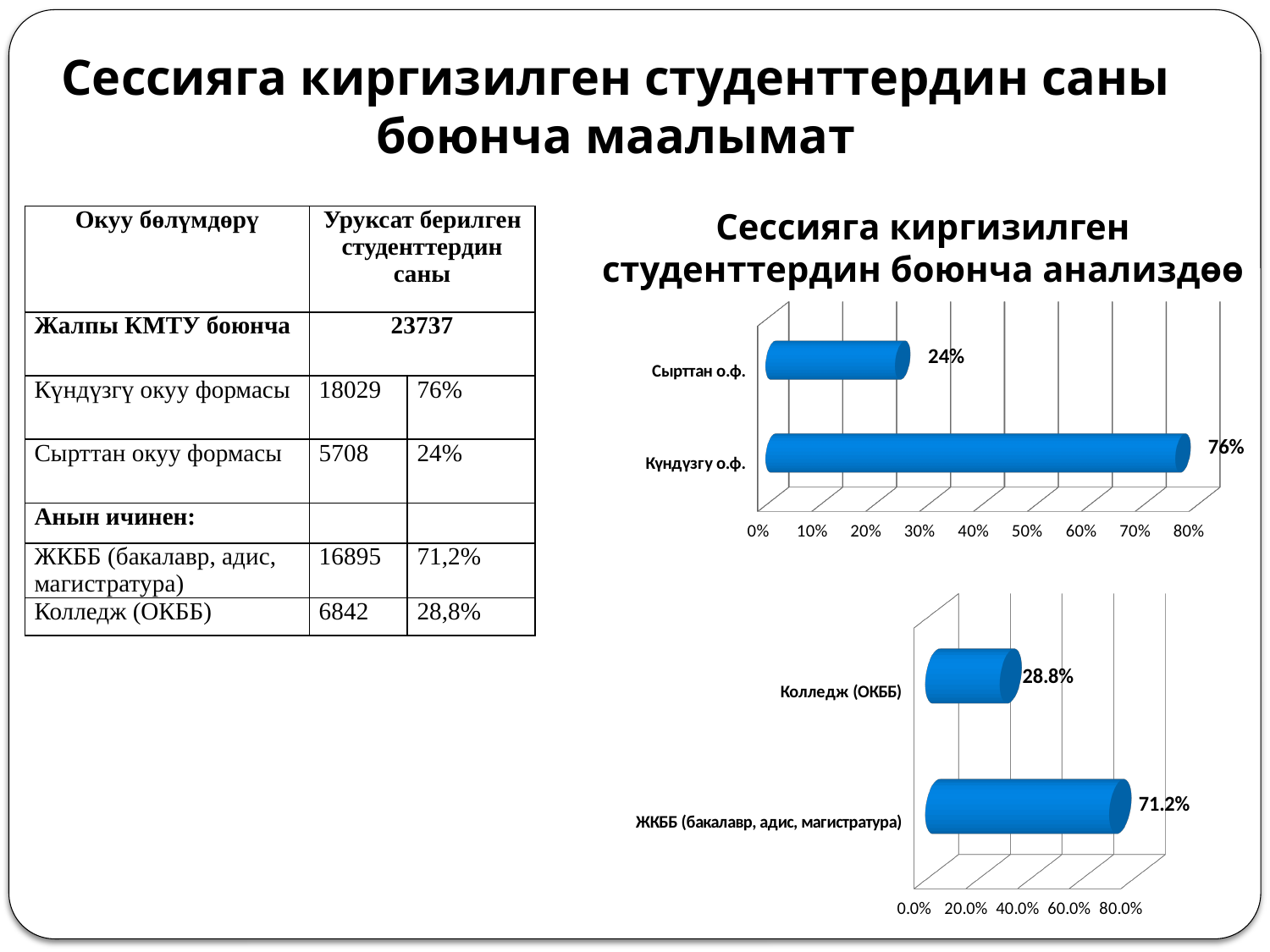
What kind of chart is the bottom chart on the slide? Bar chart In the top chart titled "Сессияга киргизилген студенттердин боюнча анализдөө", what is the value for Күндүзгү о.ф.? 76% In the bottom chart on the slide, what is the value for ЖКББ (бакалавр, адис, магистратура)? 71.2% In the bottom chart on the slide, what is the value for Колледж (ОКББ)? 28.8% In the top chart, which category has the highest value? Күндүзгү о.ф. In the top chart titled "Сессияга киргизилген студенттердин боюнча анализдөө", what is the value for Сырттан о.ф.? 24% In the bottom chart, which is larger: the value for Колледж (ОКББ) or the value for ЖКББ (бакалавр, адис, магистратура)? ЖКББ (бакалавр, адис, магистратура) What is the title of the top chart on the slide? Сессияга киргизилген студенттердин боюнча анализдөө In the top chart, which category has the lowest value? Сырттан о.ф. In the bottom chart, what is the difference between the values for ЖКББ (бакалавр, адис, магистратура) and Колледж (ОКББ)? 42.4% In the top chart, what is the difference between the values for Күндүзгү о.ф. and Сырттан о.ф.? 52% In the top chart, how many categories are plotted? 2